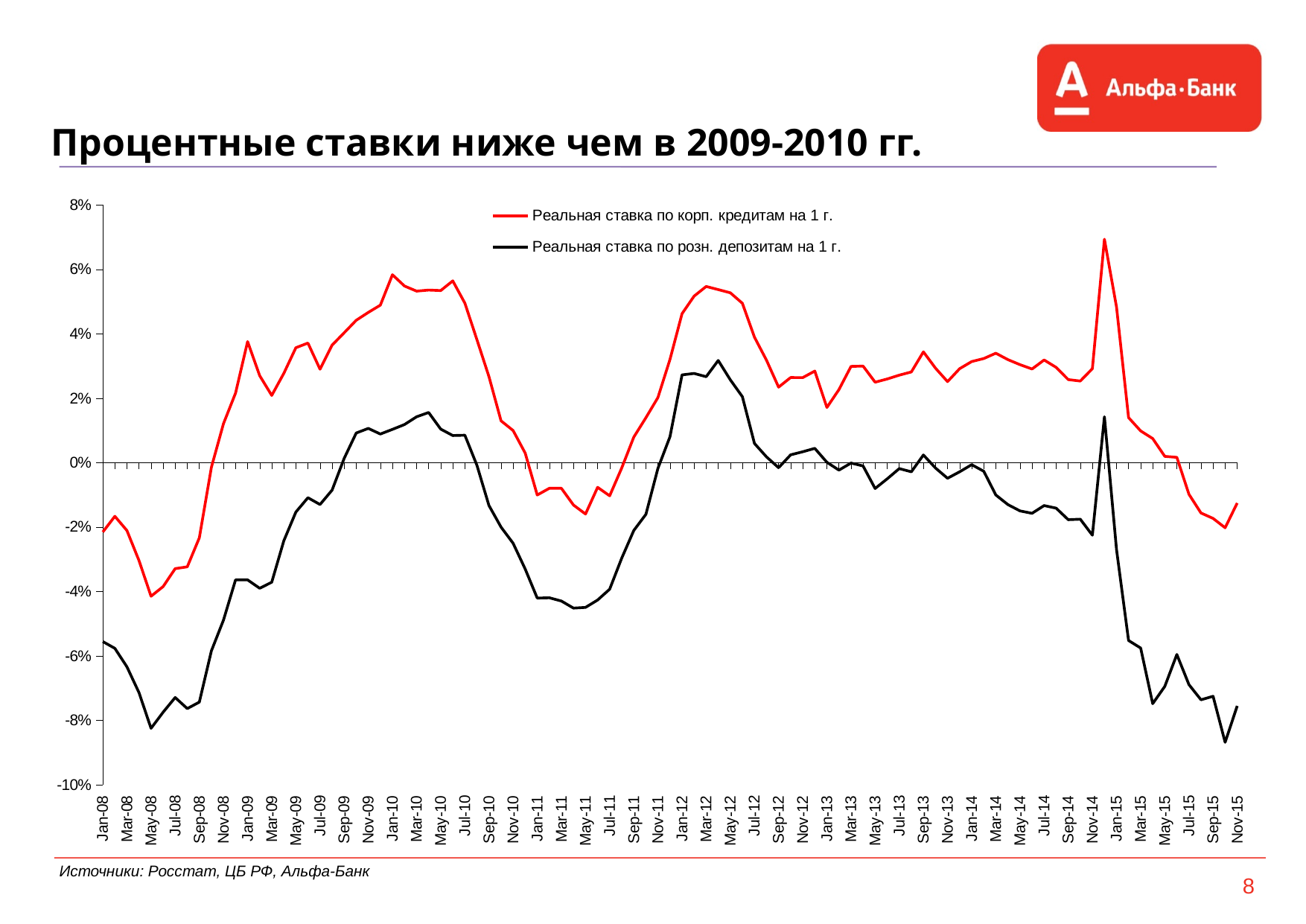
Is the peak of the real corporate loan rate (red line) around the turn of 2014/2015 greater or less than 6%? greater Does the real corporate loan rate (red line) rise or fall between Jan-08 and Jan-09? rise Is the value of the real retail deposit rate (black line) at Jan-08 greater or less than -4%? less Is the value of the real corporate loan rate (red line) at Jan-08 greater or less than 0%? less How many series does the legend list? 2 Does the real retail deposit rate (black line) rise or fall between Jan-15 and Mar-15? fall Which series is drawn in red? Реальная ставка по корп. кредитам на 1 г. At Jan-10, which series has the higher value: the real corporate loan rate or the real retail deposit rate? Реальная ставка по корп. кредитам на 1 г. What kind of chart is shown on the slide? line chart What is the title of the slide? Процентные ставки ниже чем в 2009-2010 гг.